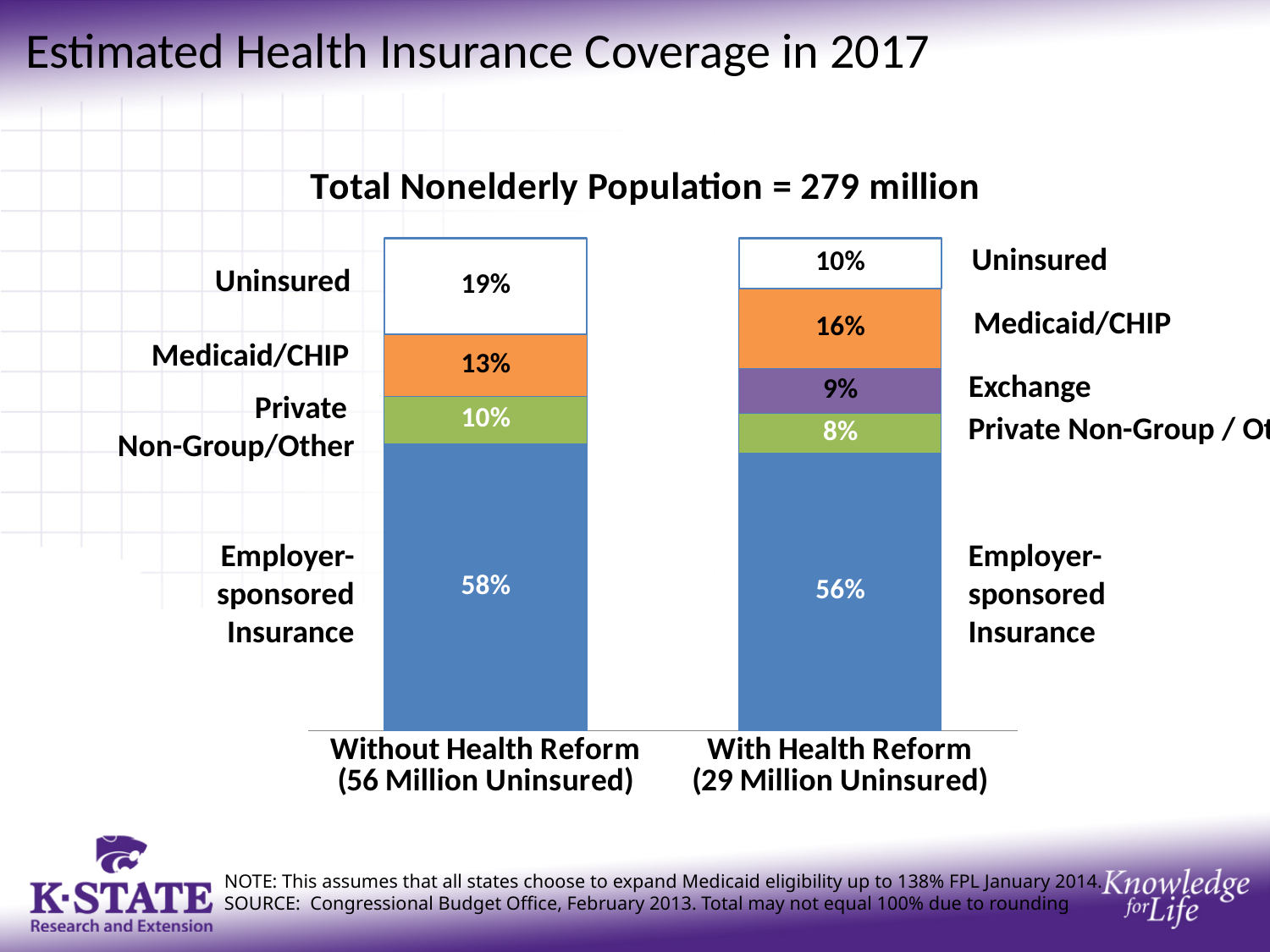
Which segment is the largest in the With Health Reform bar? Employer-sponsored Insurance How many stacked bars are shown in the chart? 2 What is the Uninsured share in the With Health Reform bar? 10% What is the Employer-sponsored Insurance share in the Without Health Reform bar? 58% What percentage is Medicaid/CHIP in the With Health Reform bar? 16% What is the Uninsured share in the Without Health Reform bar? 19% What type of chart is shown on the slide? Stacked bar chart Which segment is the smallest in the With Health Reform bar? Private Non-Group / Other What is the total of the Without Health Reform bar? 100% What is the difference in the Uninsured share between the Without Health Reform and With Health Reform bars? 9% What percentage is Exchange in the With Health Reform bar? 9% Which bar has the larger Medicaid/CHIP share, Without Health Reform or With Health Reform? With Health Reform